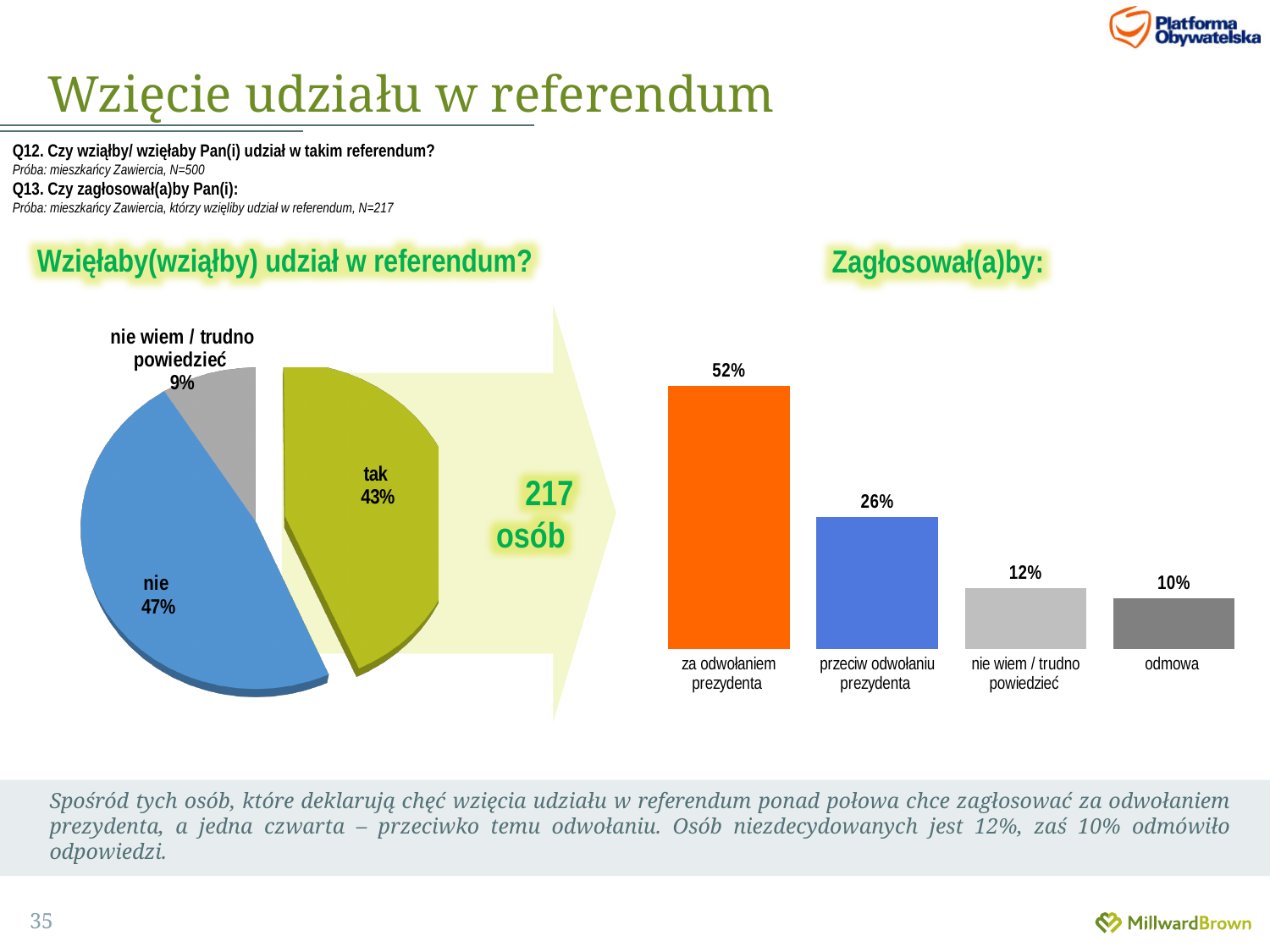
In the pie chart 'Wzięłaby(wziąłby) udział w referendum?', which slice is the smallest? nie wiem / trudno powiedzieć In the pie chart 'Wzięłaby(wziąłby) udział w referendum?', what is the value for 'tak'? 43% What type of chart is the chart on the left of the slide? pie chart In the pie chart 'Wzięłaby(wziąłby) udział w referendum?', how many slices are there? 3 In the bar chart 'Zagłosował(a)by:', which category has the lowest value? odmowa In the pie chart 'Wzięłaby(wziąłby) udział w referendum?', what is the value for 'nie'? 47% In the pie chart 'Wzięłaby(wziąłby) udział w referendum?', which slice is the largest? nie In the bar chart 'Zagłosował(a)by:', what is the value for 'za odwołaniem prezydenta'? 52% In the pie chart 'Wzięłaby(wziąłby) udział w referendum?', what is the value for 'nie wiem / trudno powiedzieć'? 9% In the bar chart 'Zagłosował(a)by:', how many categories are shown? 4 In the bar chart 'Zagłosował(a)by:', what is the value for 'przeciw odwołaniu prezydenta'? 26% In the bar chart 'Zagłosował(a)by:', what is the difference between 'za odwołaniem prezydenta' and 'przeciw odwołaniu prezydenta'? 26%